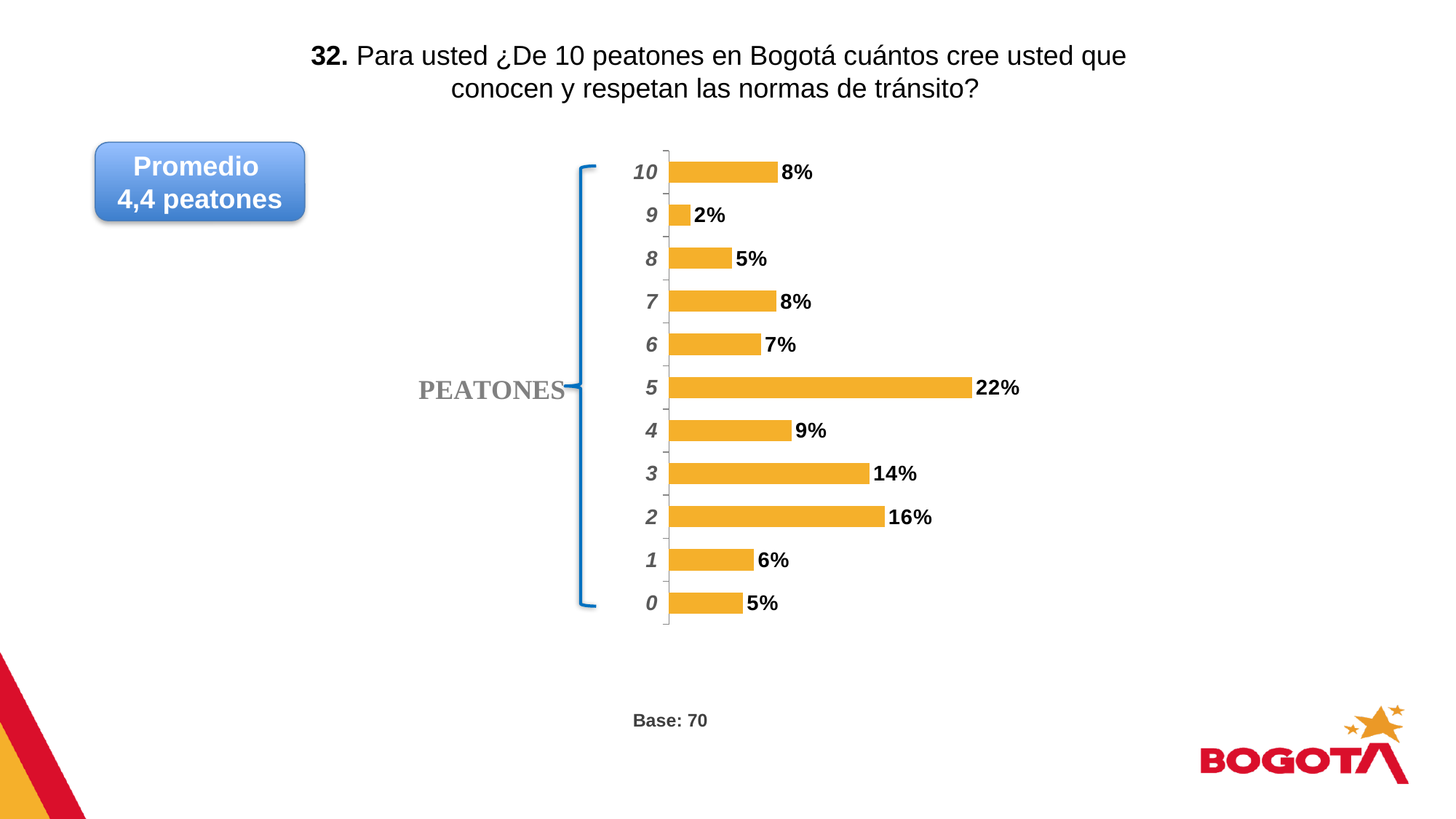
What percentage of respondents answered 0 pedestrians? 5% What percentage of respondents answered 2 pedestrians? 16% What kind of chart is shown on the slide? Bar chart What is the base (number of respondents) shown for the chart? 70 Which number of pedestrians has the lowest percentage? 9 How many categories (number of pedestrians) are shown in the chart? 11 What is the average (Promedio) number of pedestrians shown on the slide? 4,4 peatones Which has a larger percentage, the answer 2 or the answer 4? 2 What percentage of respondents answered 5 pedestrians? 22% What percentage of respondents answered 10 pedestrians? 8% What is the difference in percentage points between the answers 5 and 3? 8 Which number of pedestrians has the highest percentage? 5